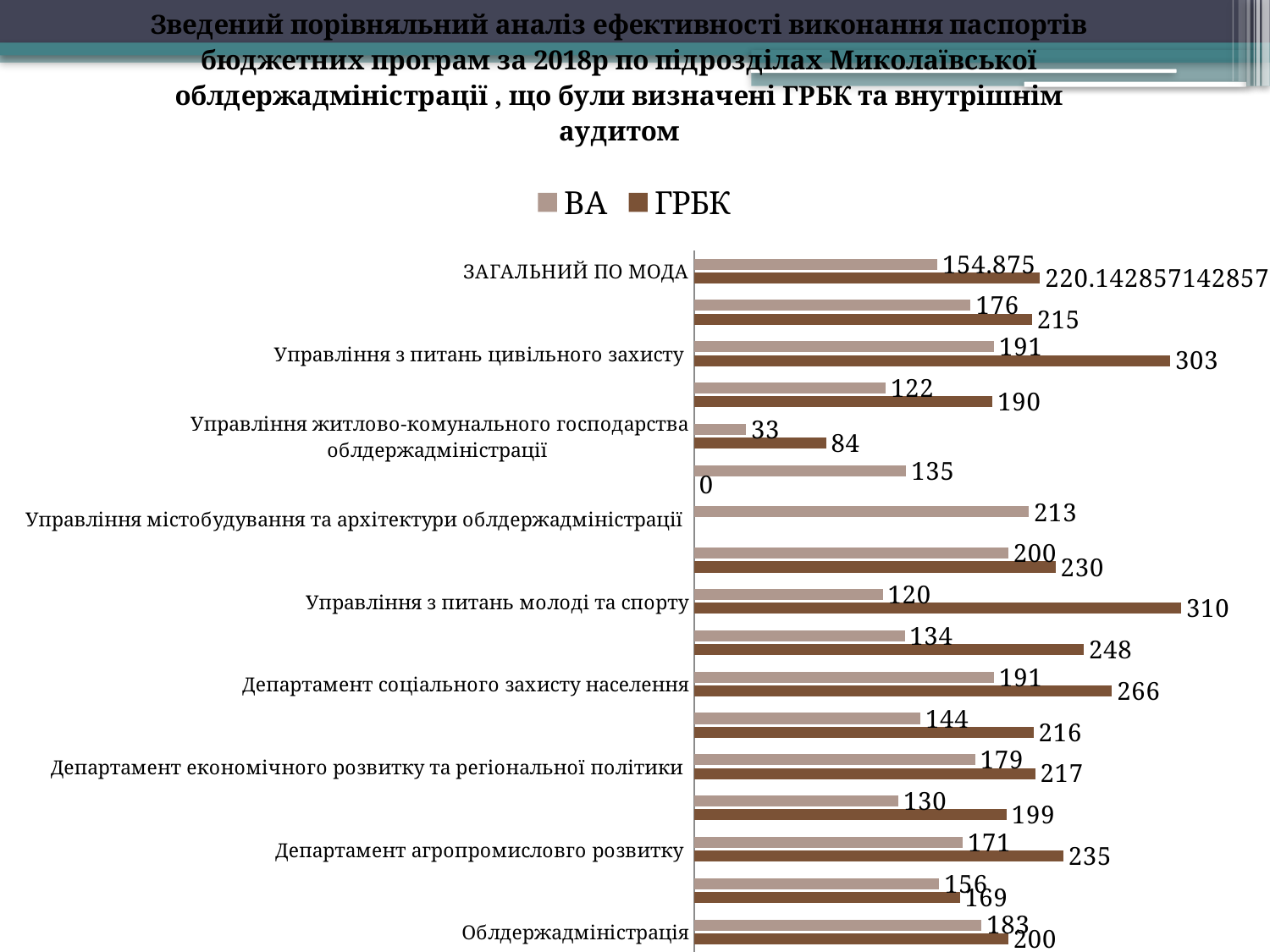
What is the ГРБК value for Департамент економічного розвитку та регіональної політики? 217 What is the ВА value for Департамент соціального захисту населення? 191 Which is larger for Облдержадміністрація, the ВА value or the ГРБК value? ГРБК What is the ГРБК value for Управління з питань молоді та спорту? 310 What is the difference between the ГРБК and ВА values for Департамент агропромисловго розвитку? 64 How many series does the legend list? 2 Which category has the highest ГРБК value? Управління з питань молоді та спорту What is the ГРБК value for ЗАГАЛЬНИЙ ПО МОДА? 220.142857142857 What is the difference between the ГРБК and ВА values for Управління з питань цивільного захисту? 112 What is the ВА value for Управління житлово-комунального господарства облдержадміністрації? 33 Which series is shown in the darker brown colour? ГРБК What type of chart is shown on the slide? bar chart